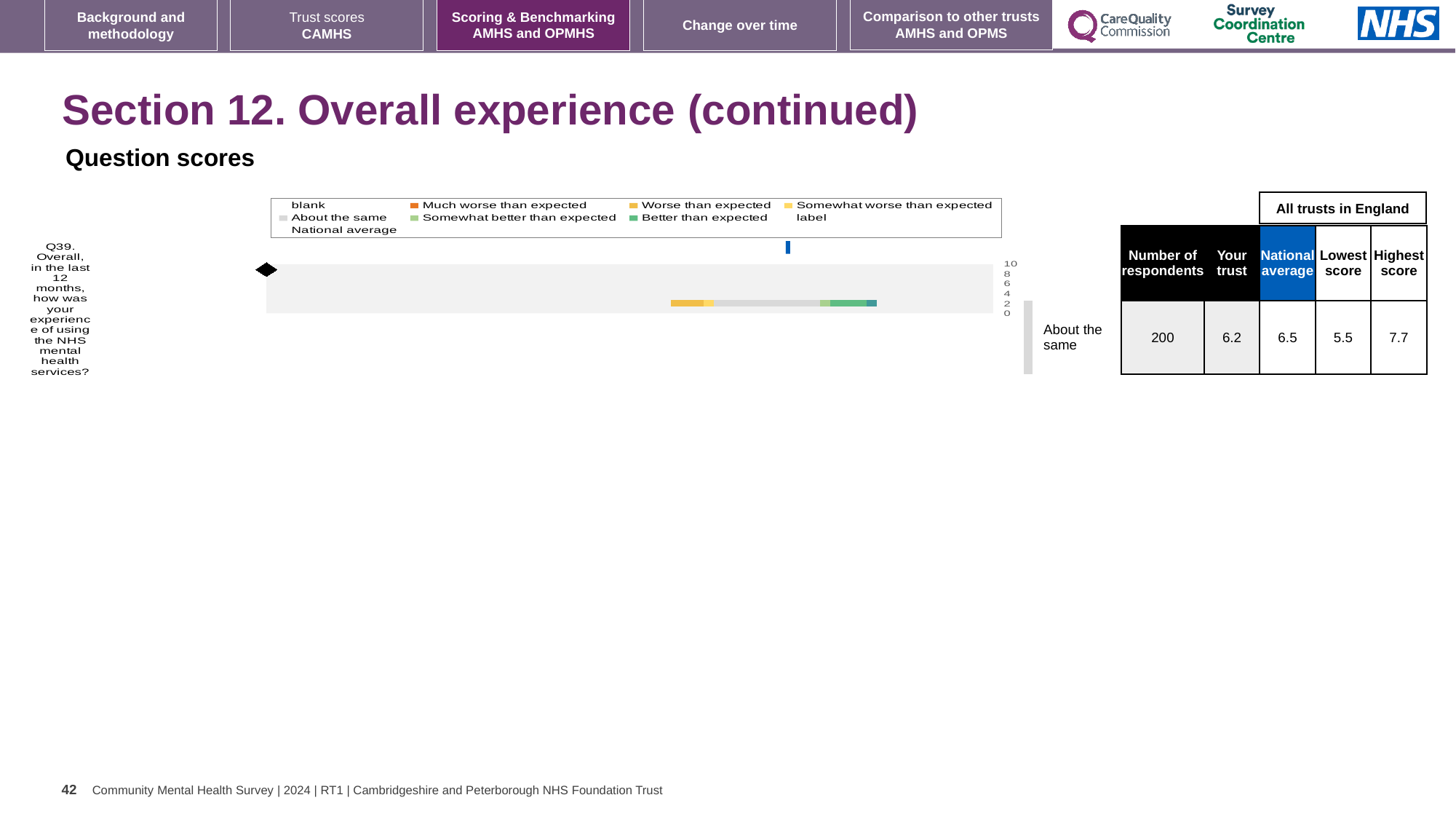
What is the difference between the highest score and the lowest score for Q39 across all trusts in England? 2.2 Which benchmark category is Q39 placed in, according to the label next to the chart? About the same What is the 'Your trust' score for Q39 in the table beside the chart? 6.2 How many entries does the chart legend list? 9 What kind of chart is used to show the Q39 question score? bar chart How many questions are plotted on the chart? 1 What is the national average score for Q39 in the table beside the chart? 6.5 What is the highest score among all trusts in England for Q39? 7.7 What is the highest tick value shown on the chart's score axis? 10 Is the 'Your trust' score for Q39 higher or lower than the national average? lower What is the lowest score among all trusts in England for Q39? 5.5 How many respondents answered Q39 for this trust? 200